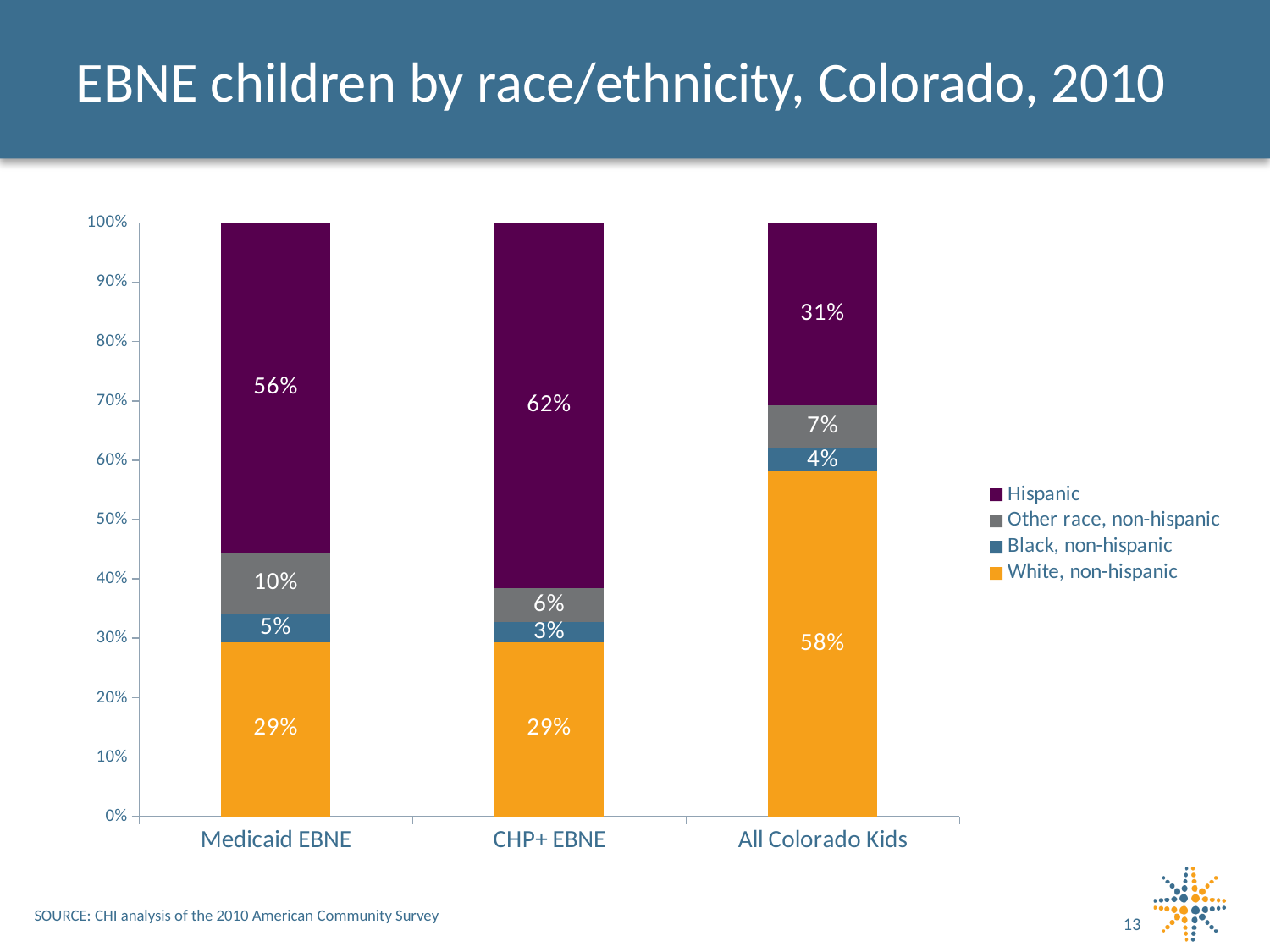
What kind of chart is shown on the slide? Stacked bar chart Which category has the lowest Hispanic share? All Colorado Kids Which category has the highest Hispanic share? CHP+ EBNE How many categories are shown on the x axis? 3 What is the Other race, non-hispanic share for Medicaid EBNE? 10% What is the difference between the Hispanic share for CHP+ EBNE and for Medicaid EBNE? 6% How many series does the legend list? 4 What is the White, non-hispanic share for All Colorado Kids? 58% What is the Black, non-hispanic share for CHP+ EBNE? 3% What is the Hispanic share for Medicaid EBNE? 56% Is the Other race, non-hispanic share larger for Medicaid EBNE or for All Colorado Kids? Medicaid EBNE What is the title of the chart? EBNE children by race/ethnicity, Colorado, 2010